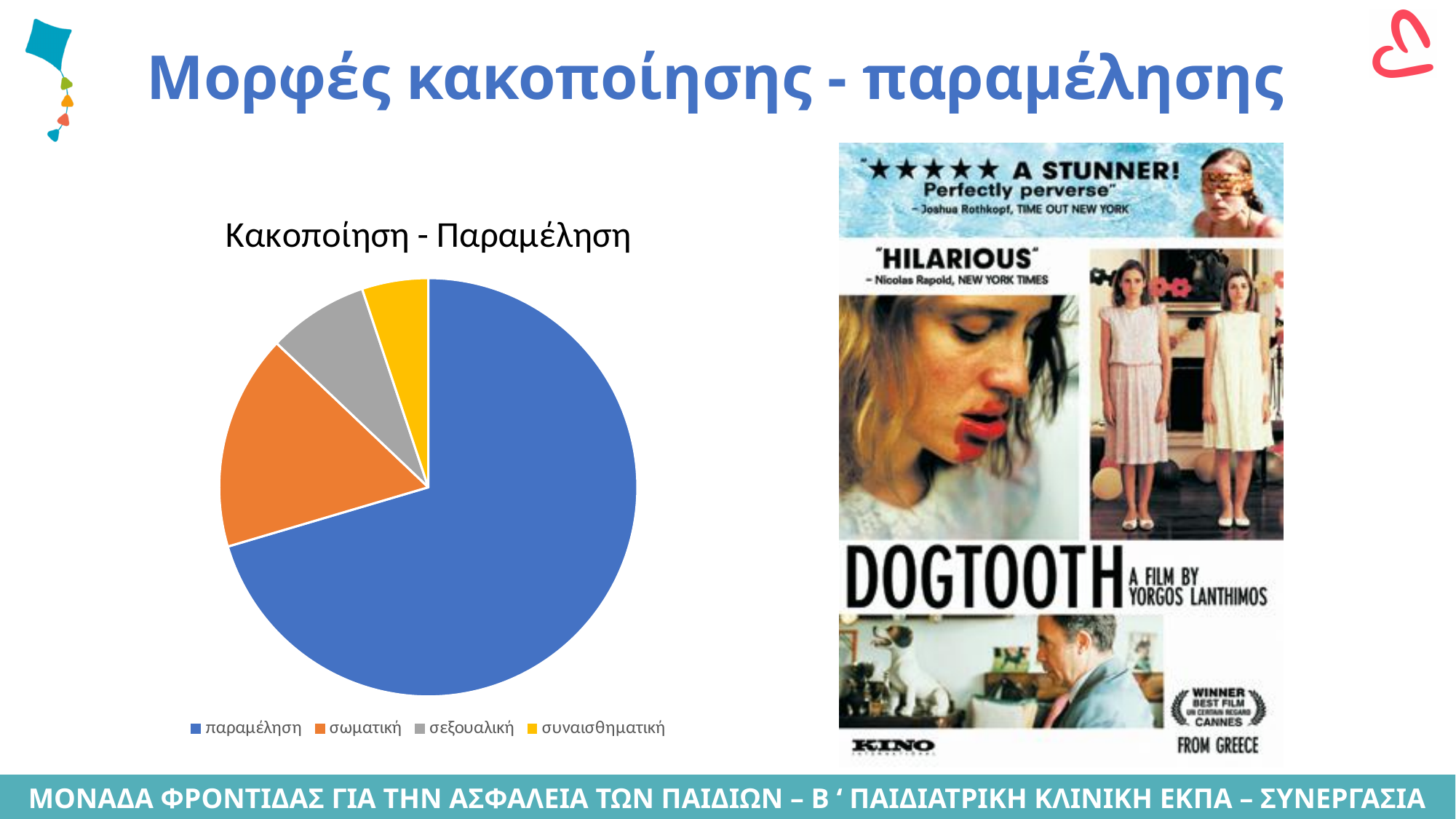
How many slices does the pie chart have? 4 How many entries does the legend of the pie chart list? 4 What is the title of the pie chart? Κακοποίηση - Παραμέληση What kind of chart is shown on the slide? pie chart Which colour represents παραμέληση in the pie chart? blue Which category has the largest slice in the pie chart? παραμέληση Which slice is larger in the pie chart, σωματική or σεξουαλική? σωματική Which category has the smallest slice in the pie chart? συναισθηματική Which slice is larger in the pie chart, παραμέληση or σωματική? παραμέληση Which slice is larger in the pie chart, σεξουαλική or συναισθηματική? σεξουαλική